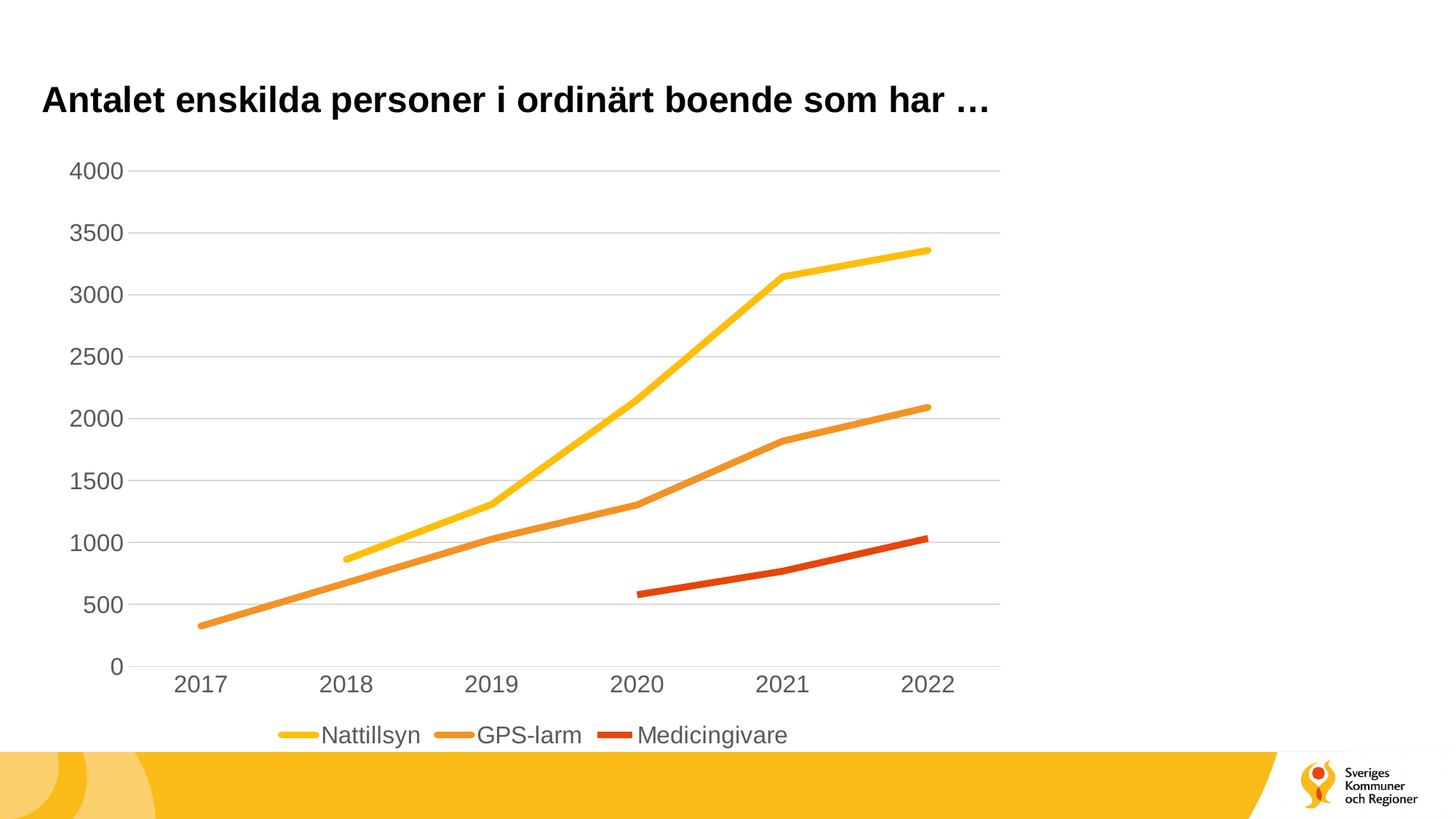
Is the value for Nattillsyn in 2022 greater or less than 3000? greater Is the value for Medicingivare in 2020 greater or less than 1000? less How many years are shown on the x axis? 6 Which is larger in 2021, the value for GPS-larm or the value for Medicingivare? GPS-larm Is the value for GPS-larm in 2017 greater or less than 500? less What kind of chart is shown on the slide? line chart Does the Nattillsyn line rise or fall from 2018 to 2022? rise Which series starts in 2020 rather than earlier? Medicingivare How many series does the legend list? 3 Which series has the highest value in 2022? Nattillsyn What is the first year shown on the x axis? 2017 Which series has the lowest value in 2022? Medicingivare